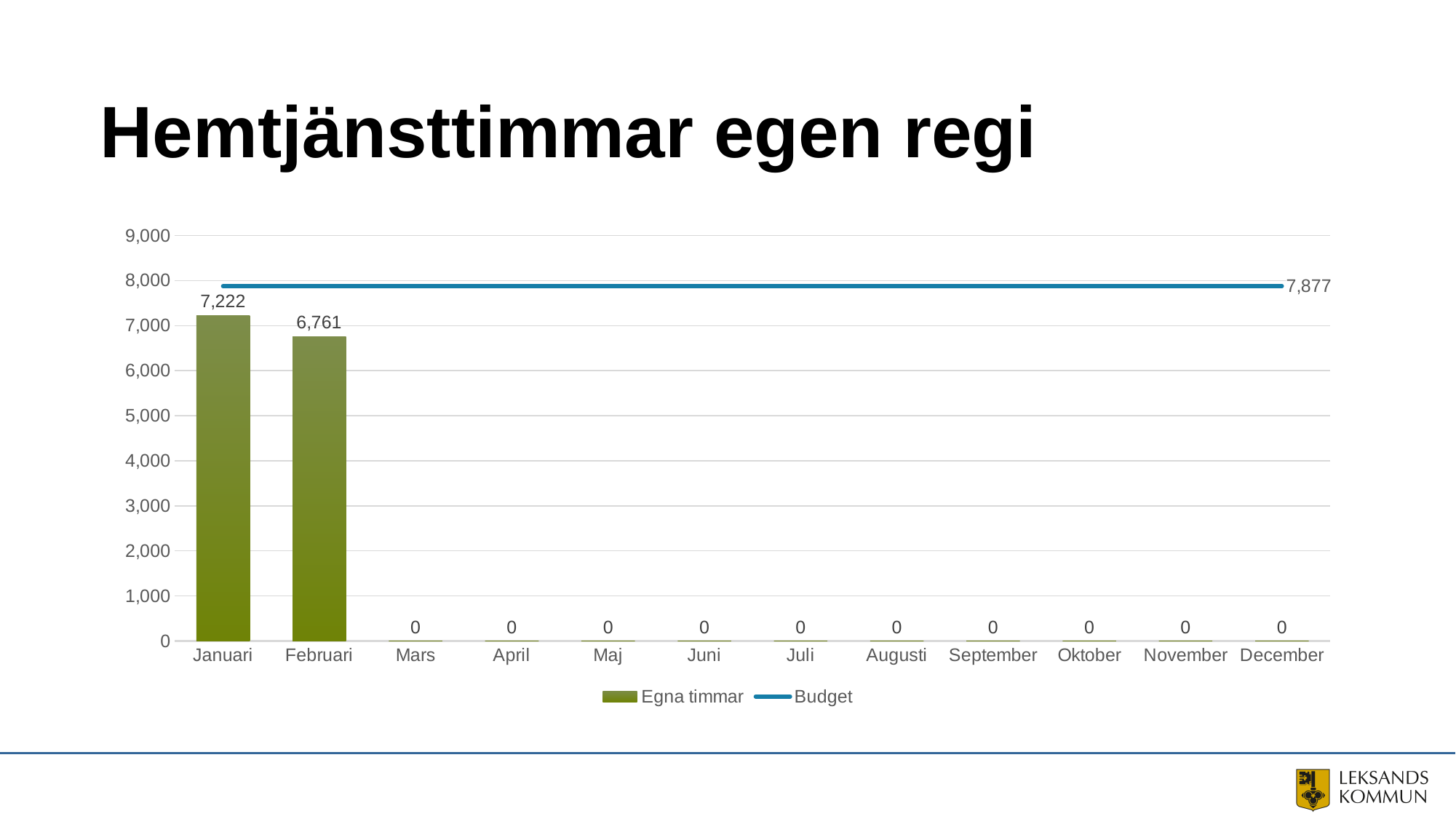
What is the Budget value shown on the chart? 7,877 Which month has the highest value for Egna timmar? Januari What is the difference between the Budget value and the Egna timmar value for Januari? 655 Which is larger, the Egna timmar value for Februari or the Budget value? Budget What is the value of Egna timmar for Mars? 0 Is the Egna timmar value for Januari greater or less than 7,000? greater How many series does the legend list? 2 What is the value of Egna timmar for Februari? 6,761 What is the title of the slide containing the chart? Hemtjänsttimmar egen regi What is the difference between the Egna timmar values for Januari and Februari? 461 What is the value of Egna timmar for Januari? 7,222 How many months are shown on the x axis? 12